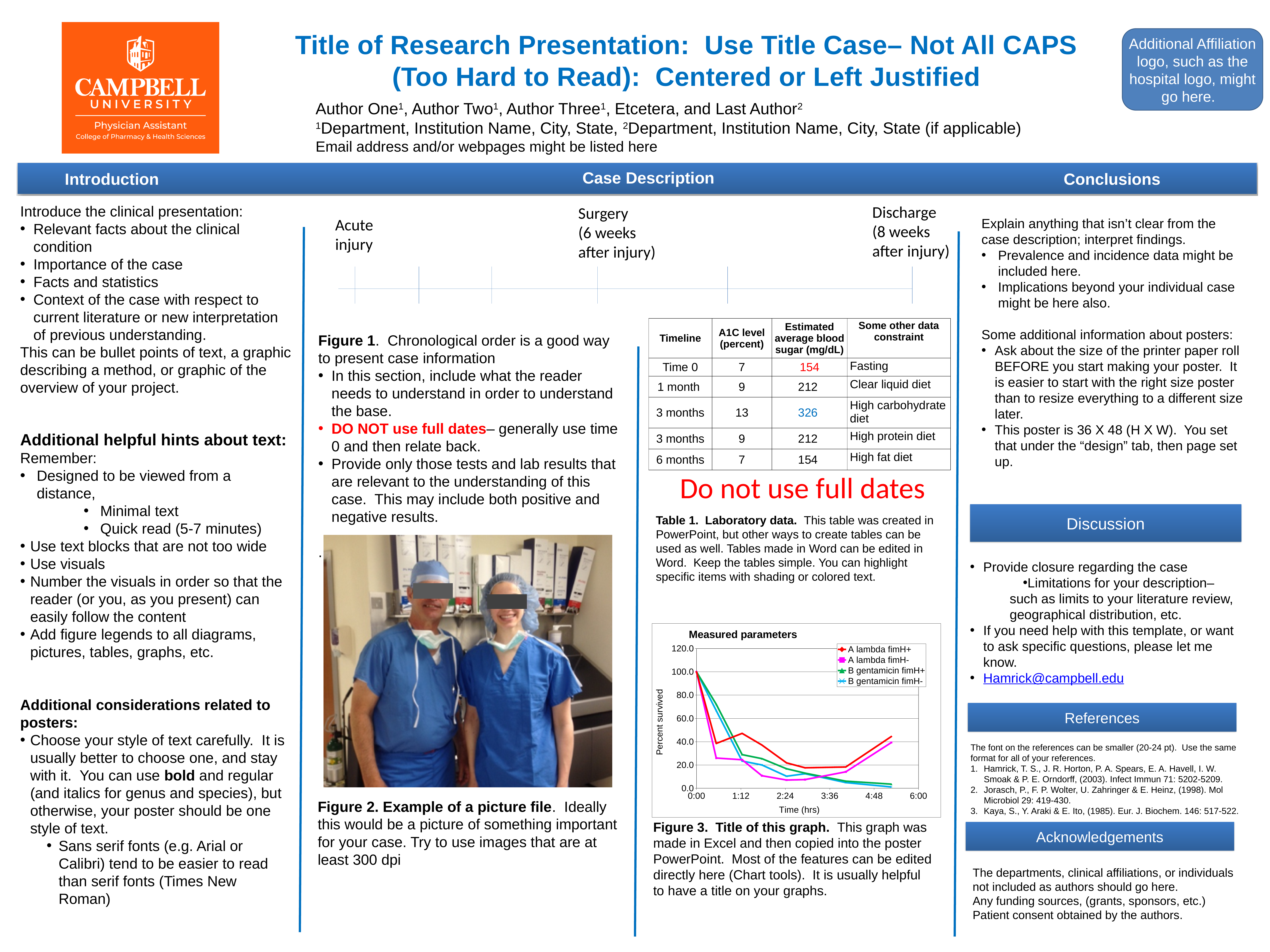
In the "Measured parameters" chart, at 4:48, which is larger: A lambda fimH+ or B gentamicin fimH-? A lambda fimH+ In the "Measured parameters" chart, is the value for A lambda fimH- at 1:12 greater or less than 60.0? less How many tick labels are shown on the x axis of the "Measured parameters" chart? 6 In the "Measured parameters" chart, is the value for B gentamicin fimH- at 2:24 greater or less than 40.0? less What is the title of the chart on the slide? Measured parameters In the "Measured parameters" chart, is the value for A lambda fimH+ at 2:24 greater or less than 40.0? less What is the y-axis label of the "Measured parameters" chart? Percent survived In the "Measured parameters" chart, does the B gentamicin fimH+ series rise or fall over time? fall What kind of chart is the "Measured parameters" chart? line chart How many series does the legend of the "Measured parameters" chart list? 4 In the "Measured parameters" chart, what is the value of every series at time 0:00? 100.0